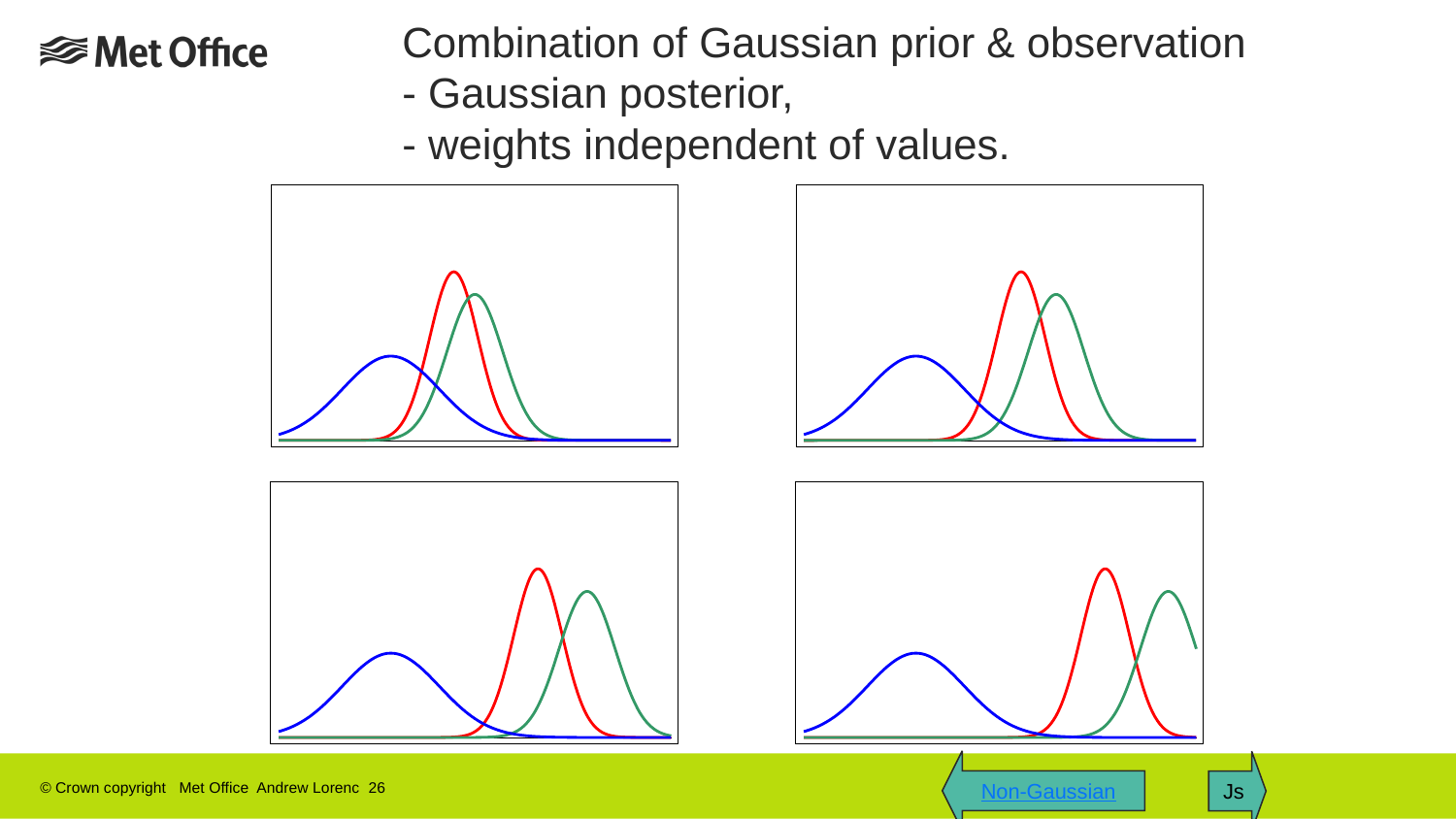
How many curves are plotted in the bottom-right chart? 3 In the top-right chart, which coloured curve has the lowest peak? blue In the bottom-right chart, which coloured curve has the highest peak? red What kind of chart is shown in the top-left panel? line chart In the bottom-left chart, which coloured curve has the lowest peak? blue How many charts are shown on the slide? 4 How many curves are plotted in the top-left chart? 3 What three colours are used for the curves in each chart? blue, red and green In the bottom-left chart, which coloured curve is positioned furthest to the left along the x axis? blue In the top-left chart, which coloured curve has the highest peak? red In the top-right chart, which curve peaks higher, the red curve or the green curve? red In the bottom-right chart, which curve peaks higher, the blue curve or the green curve? green